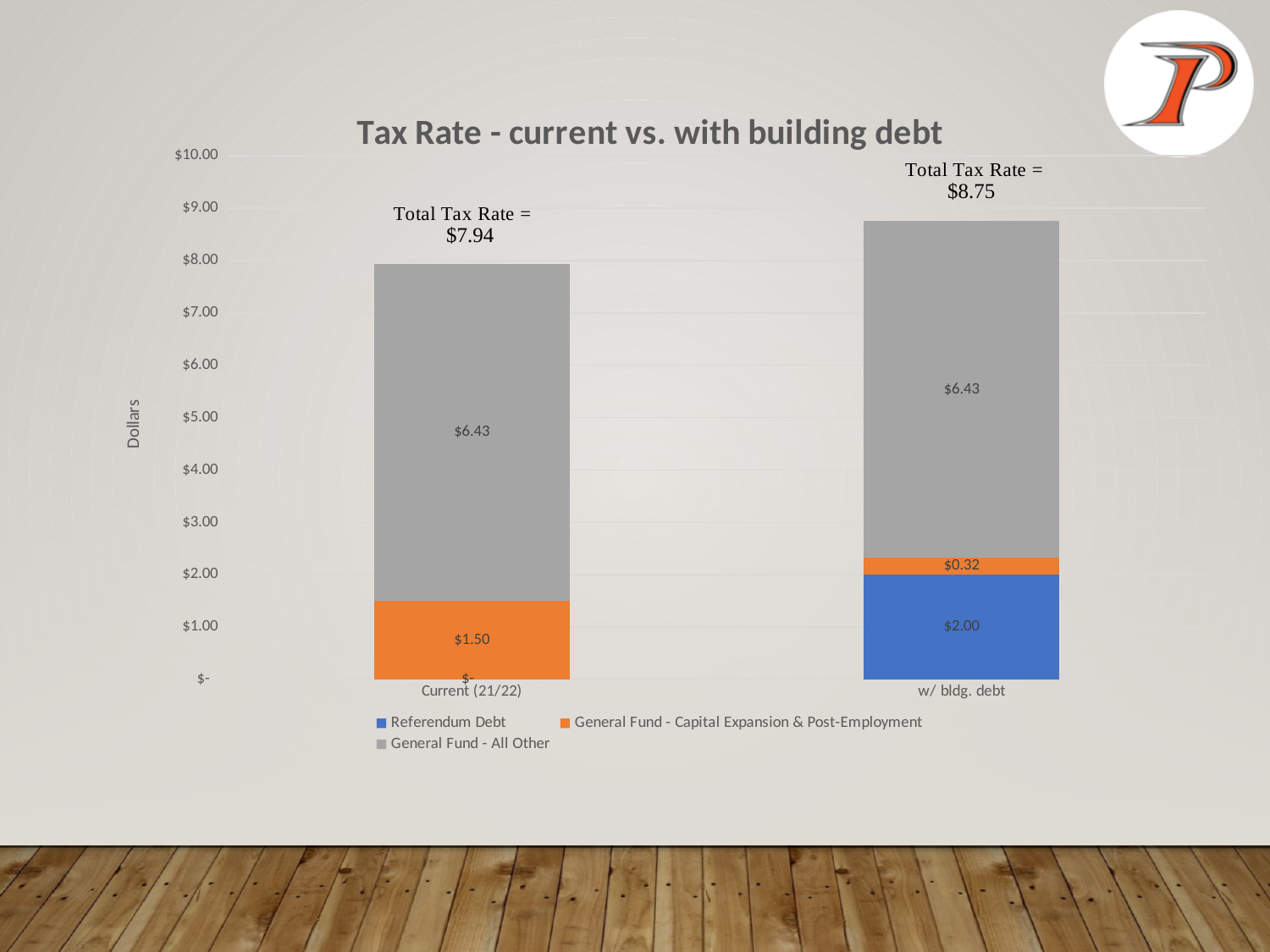
What is the value of General Fund - All Other for Current (21/22)? $6.43 Which bar has the larger total tax rate, Current (21/22) or w/ bldg. debt? w/ bldg. debt What is the value of General Fund - Capital Expansion & Post-Employment for Current (21/22)? $1.50 What is the total tax rate shown for the Current (21/22) bar? $7.94 What is the difference in General Fund - Capital Expansion & Post-Employment between Current (21/22) and w/ bldg. debt? $1.18 What is the value of Referendum Debt for w/ bldg. debt? $2.00 What kind of chart is shown on the slide? Stacked bar chart How many series does the legend list? 3 What is the total tax rate shown for the w/ bldg. debt bar? $8.75 What is the label on the y axis? Dollars How many categories are shown on the x axis? 2 What is the value of General Fund - Capital Expansion & Post-Employment for w/ bldg. debt? $0.32